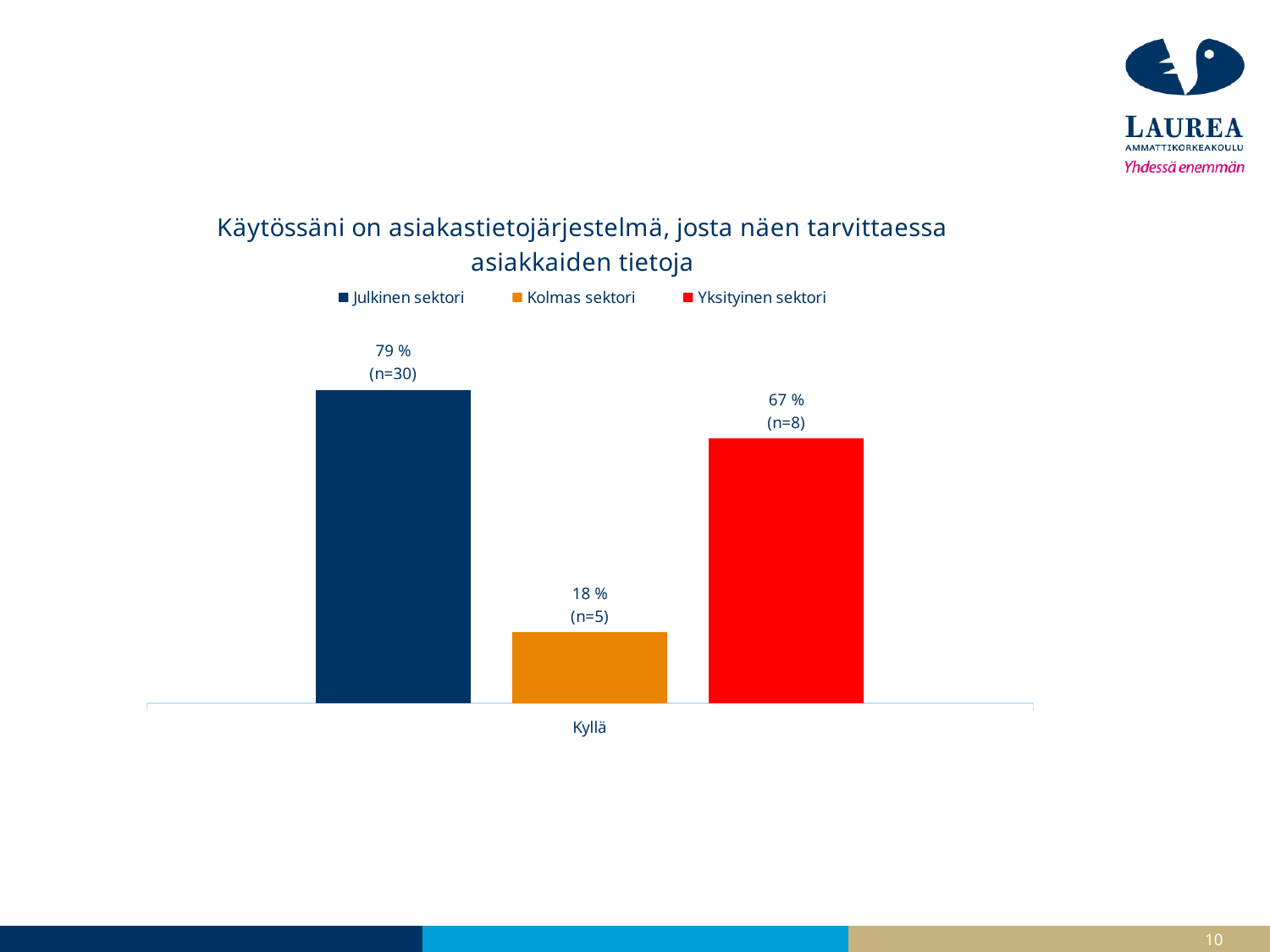
What percentage is shown for Kolmas sektori? 18 % What is the category label on the x axis? Kyllä Which is larger, the percentage for Kolmas sektori or for Yksityinen sektori? Yksityinen sektori What is the n value shown for Julkinen sektori? n=30 What is the n value shown for Yksityinen sektori? n=8 What kind of chart is shown? Bar chart What is the difference in percentage points between Julkinen sektori and Yksityinen sektori? 12 What percentage is shown for Julkinen sektori? 79 % How many series does the legend list? 3 Which series has the highest percentage? Julkinen sektori Which series has the lowest percentage? Kolmas sektori What percentage is shown for Yksityinen sektori? 67 %